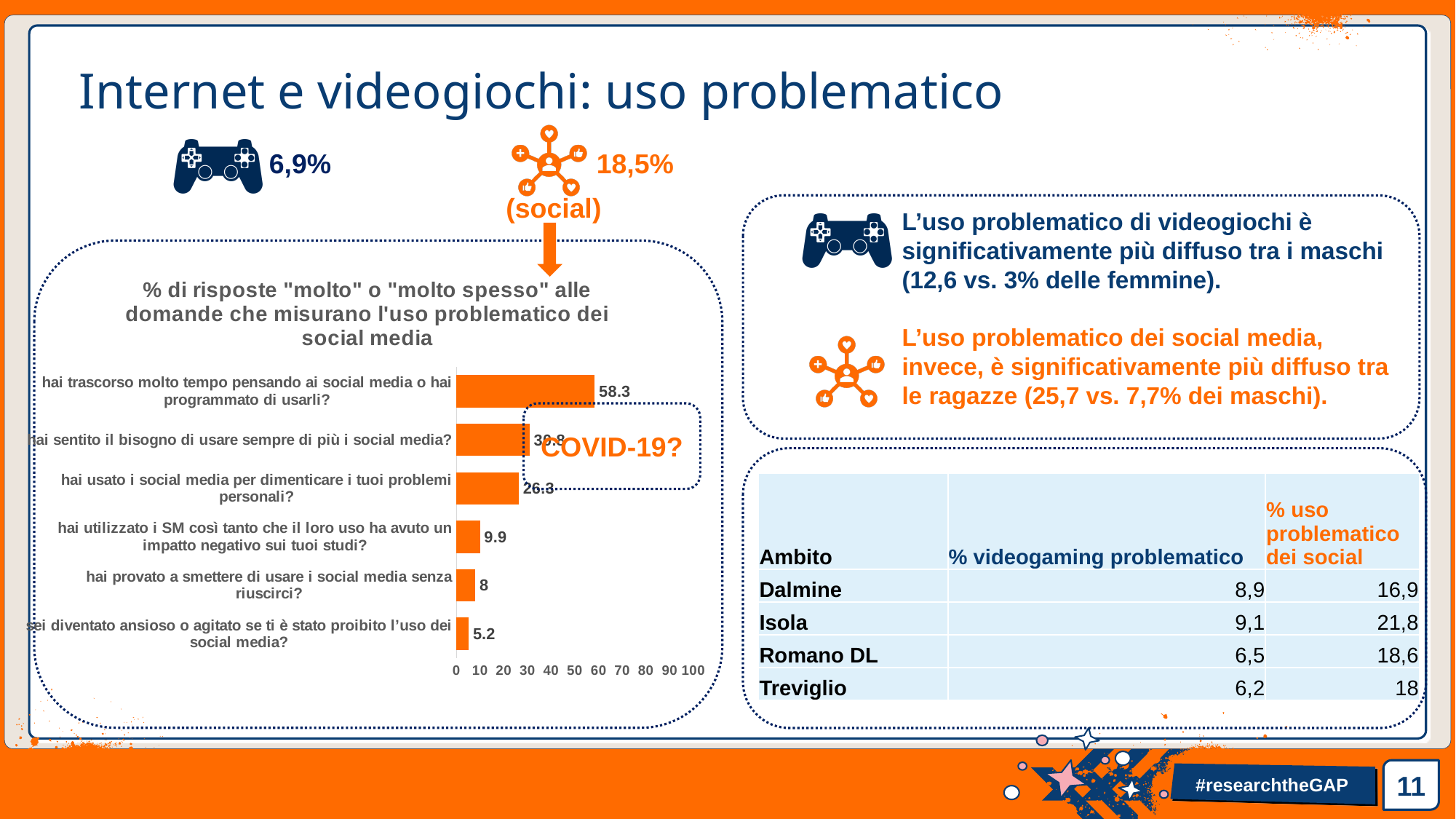
What is the title of the bar chart? % di risposte "molto" o "molto spesso" alle domande che misurano l'uso problematico dei social media Which question in the bar chart has the lowest percentage? sei diventato ansioso o agitato se ti è stato proibito l'uso dei social media? What is the value for "hai trascorso molto tempo pensando ai social media o hai programmato di usarli?"? 58.3 What is the value for "hai utilizzato i SM così tanto che il loro uso ha avuto un impatto negativo sui tuoi studi?"? 9.9 Is the value for "hai sentito il bisogno di usare sempre di più i social media?" greater or less than 20? greater What is the value for "hai provato a smettere di usare i social media senza riuscirci?"? 8 What is the value for "sei diventato ansioso o agitato se ti è stato proibito l'uso dei social media?"? 5.2 How many questions (categories) are plotted in the bar chart? 6 What kind of chart is shown on the slide? bar chart What is the difference between the value for "hai utilizzato i SM così tanto che il loro uso ha avuto un impatto negativo sui tuoi studi?" and the value for "sei diventato ansioso o agitato se ti è stato proibito l'uso dei social media?"? 4.7 Is the value for "hai usato i social media per dimenticare i tuoi problemi personali?" greater or less than 30? less Which question in the bar chart has the highest percentage? hai trascorso molto tempo pensando ai social media o hai programmato di usarli?